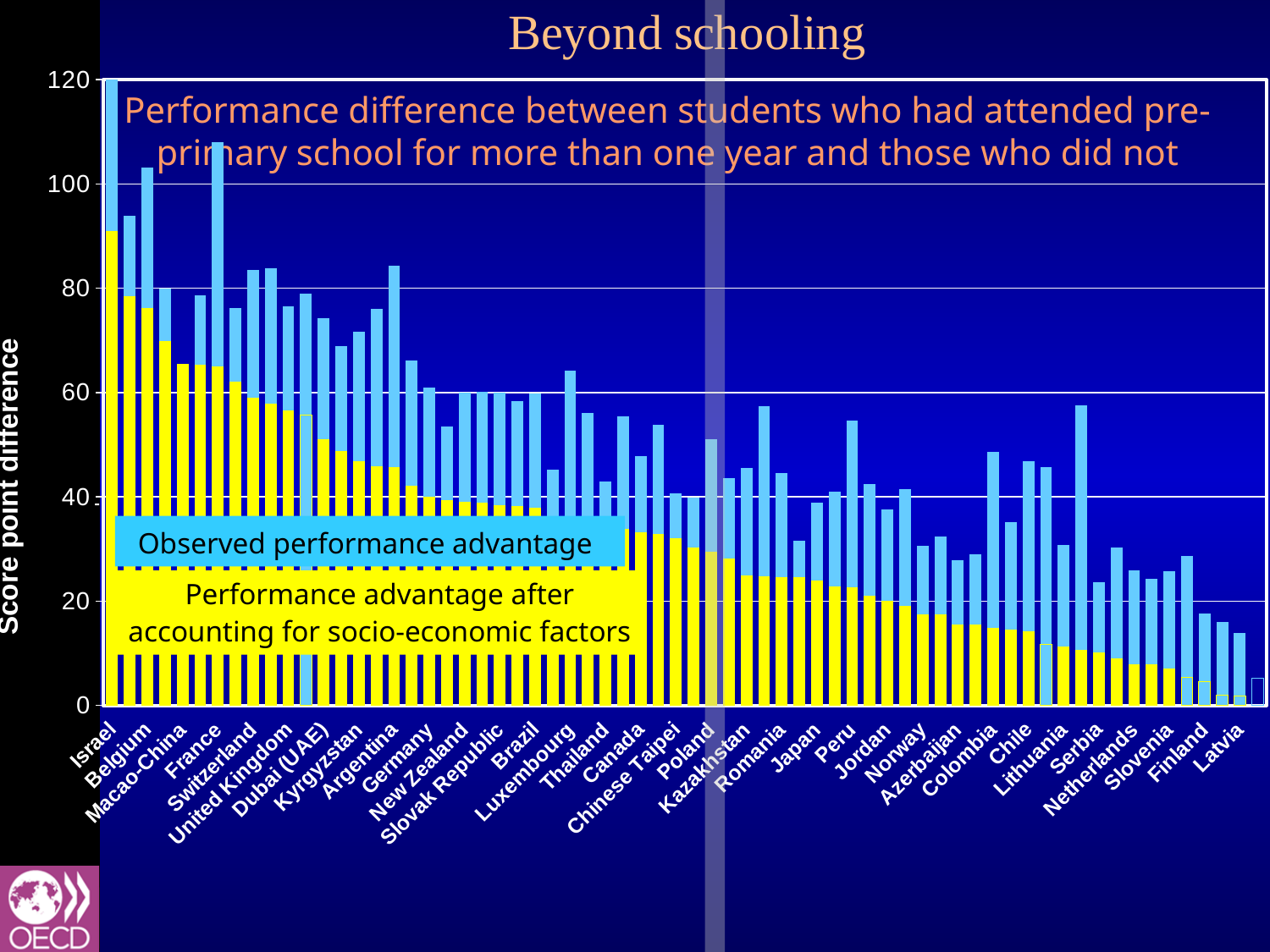
How many series does the chart's legend list? 2 What kind of chart is shown on the slide? bar chart What is the label on the vertical axis of the chart? Score point difference Do the observed performance advantage values rise or fall from left to right along the x axis? fall Which country has a larger observed performance advantage, Israel or Latvia? Israel Is the performance advantage after accounting for socio-economic factors for Israel greater or less than 80? greater Is the observed performance advantage for Latvia greater or less than 20? less Which colour represents the performance advantage after accounting for socio-economic factors? yellow Is the observed performance advantage for Israel greater or less than 100? greater Which country has the highest observed performance advantage? Israel